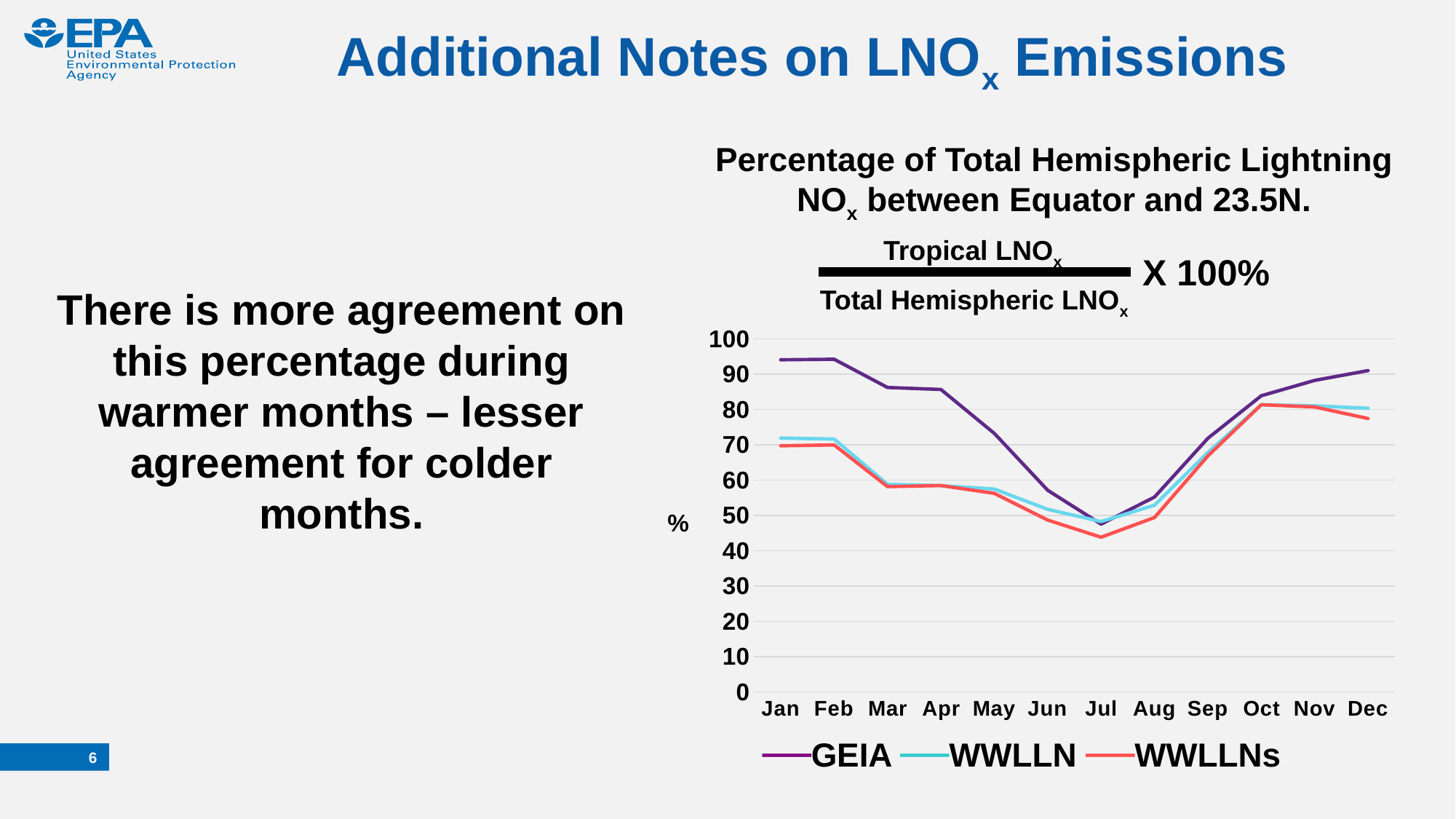
What label is shown on the y axis of the chart? % How many series does the legend of the chart list? 3 Is the GEIA value for Jan greater or less than 90? greater Does the GEIA series rise or fall from Jan to Jul? fall In which month does the GEIA series reach its lowest value? Jul In Jan, which series has the larger value, GEIA or WWLLNs? GEIA In which month does the WWLLN series reach its lowest value? Jul Is the WWLLNs value for Jul greater or less than 50? less How many months are plotted along the x axis of the chart? 12 What kind of chart is shown on the slide? line chart Is the WWLLN value for Jun greater or less than 60? less Does the WWLLN series rise or fall from Jul to Oct? rise